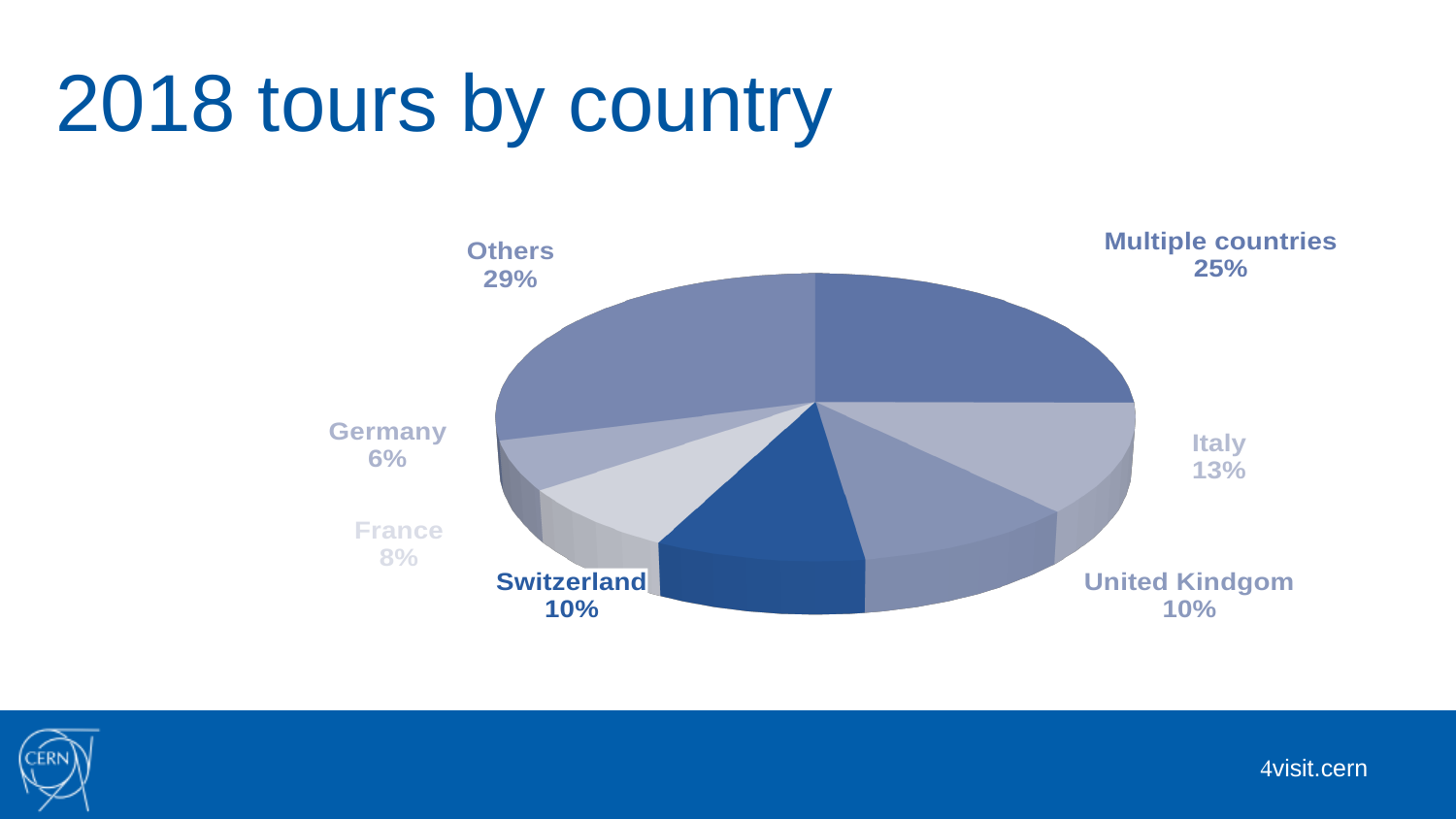
How many slices does the pie chart have? 7 Which category has the smallest share of the pie? Germany What is the title of the chart? 2018 tours by country Which has a larger share, Italy or France? Italy What share of 2018 tours is labelled for Germany? 6% What share of 2018 tours is labelled for Italy? 13% What share of 2018 tours is labelled for Multiple countries? 25% What kind of chart is shown on the slide? pie chart Which two countries each have a 10% share? Switzerland and United Kindgom What share of 2018 tours is labelled for France? 8% What is the difference in percentage points between Others and Multiple countries? 4 Which category has the largest share of the pie? Others